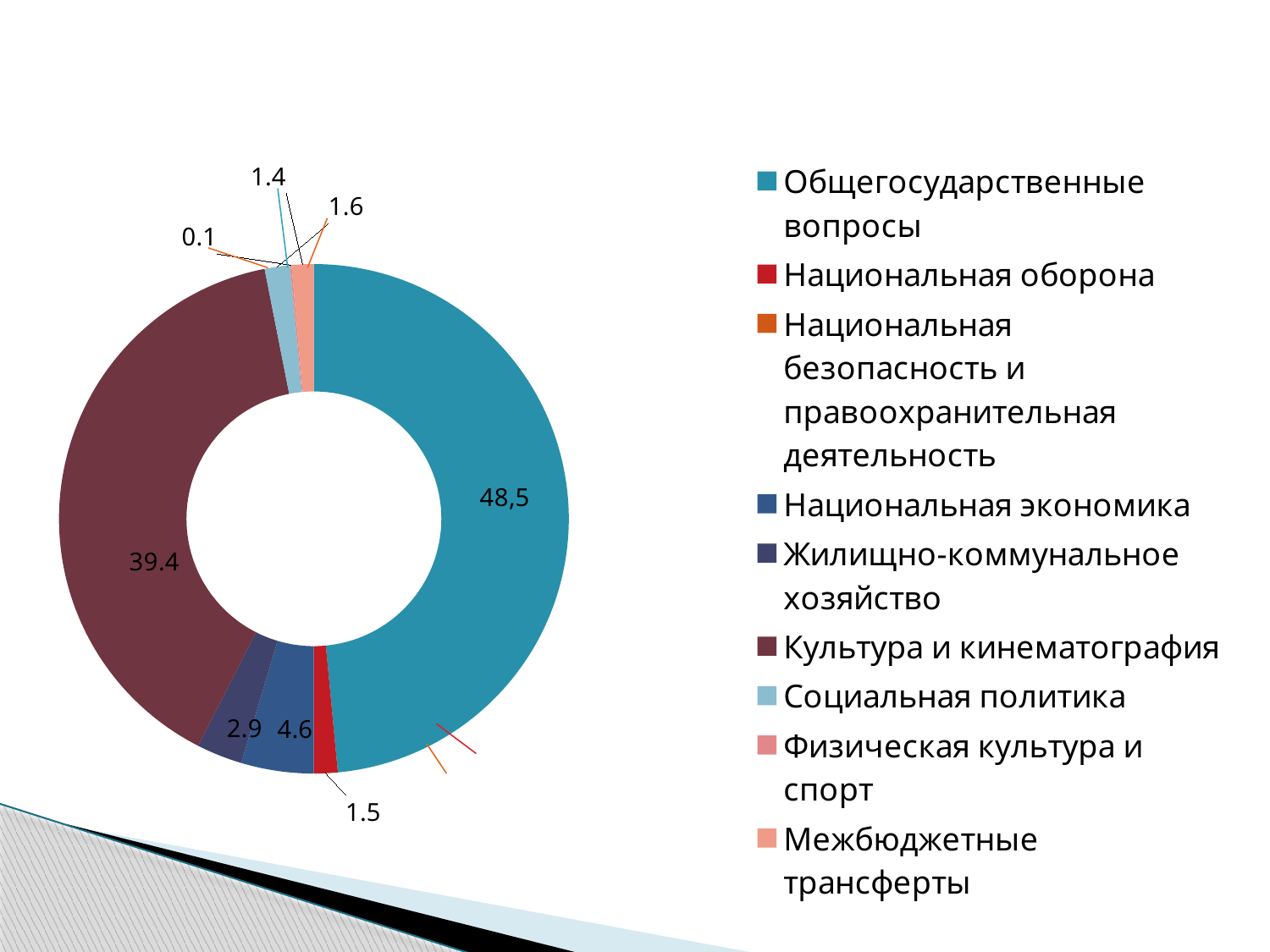
What is the value shown for Культура и кинематография? 39.4 What is the value shown for Общегосударственные вопросы? 48,5 What is the value shown for Национальная оборона? 1.5 What is the difference between the values for Общегосударственные вопросы and Культура и кинематография? 9.1 What kind of chart is shown on the slide? doughnut chart What is the value shown for Национальная экономика? 4.6 What is the value shown for Жилищно-коммунальное хозяйство? 2.9 How many categories does the legend list? 9 Which is larger, Национальная экономика or Жилищно-коммунальное хозяйство? Национальная экономика What colour is the slice for Культура и кинематография? dark red (maroon) Which category has the largest slice? Общегосударственные вопросы What is the difference between the values for Национальная экономика and Жилищно-коммунальное хозяйство? 1.7